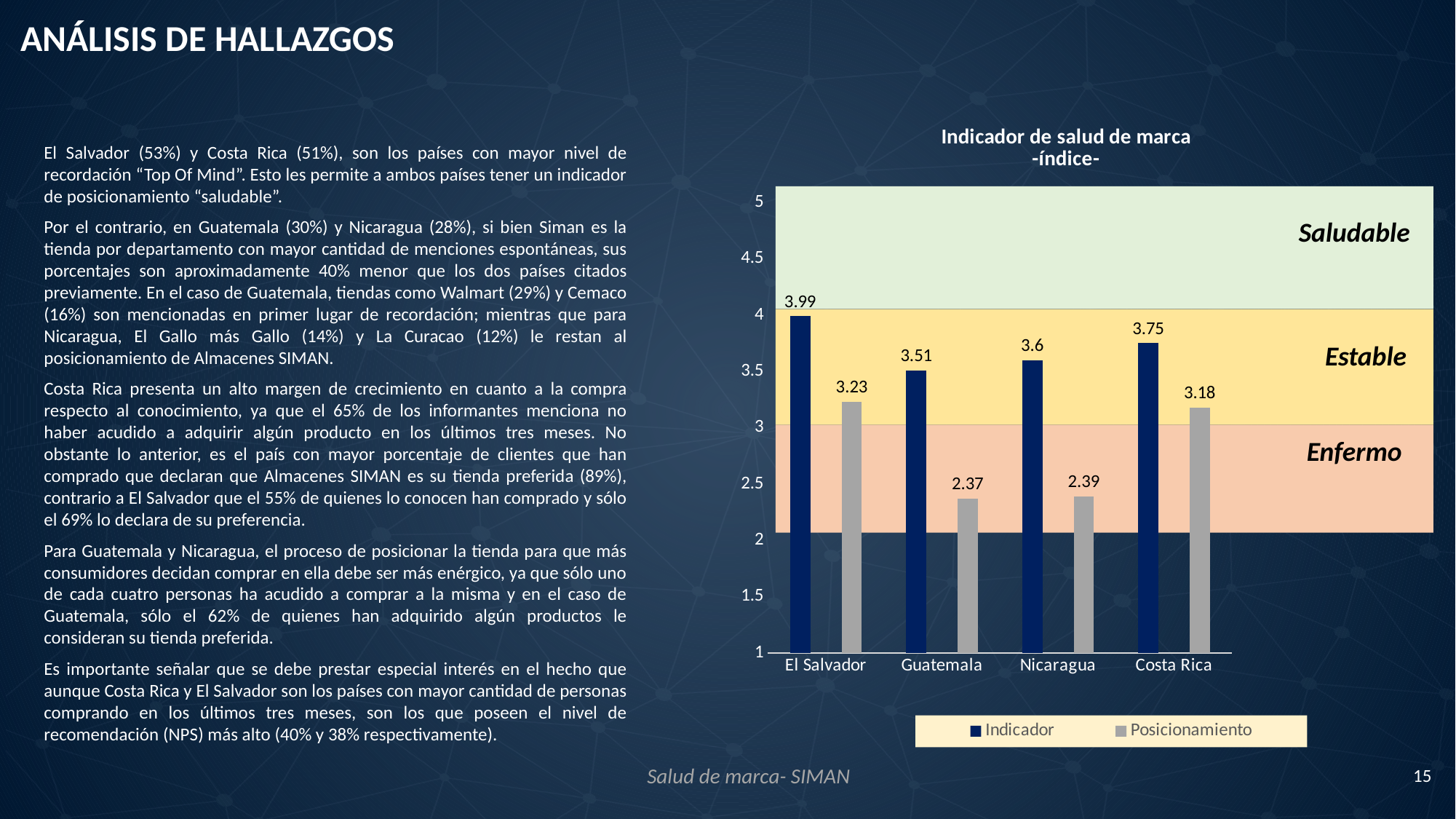
Is the Posicionamiento value for Nicaragua greater or less than 3? less Which is larger, the Posicionamiento value for El Salvador or for Costa Rica? El Salvador What kind of chart is shown? bar chart Which country has the highest Indicador value? El Salvador How many series does the legend list? 2 How many countries are shown on the x axis? 4 What is the Posicionamiento value for Guatemala? 2.37 What is the difference between the Indicador and Posicionamiento values for Nicaragua? 1.21 Which country has the lowest Posicionamiento value? Guatemala What is the title of the chart? Indicador de salud de marca -índice- What is the Indicador value for Costa Rica? 3.75 What is the Indicador value for El Salvador? 3.99